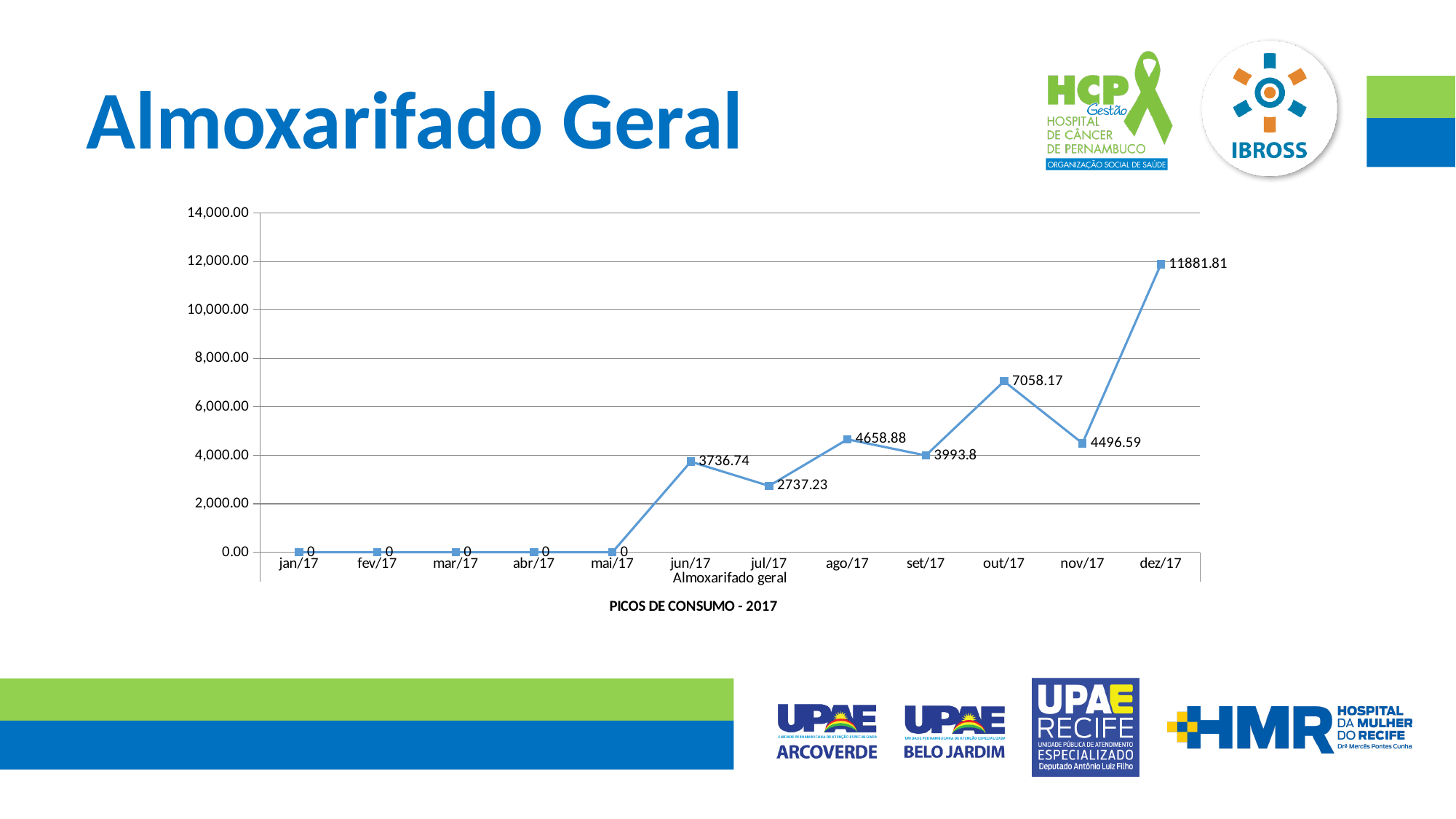
What is the value for set/17? 3993.8 Which month has the highest value? dez/17 How many months are plotted on the x axis? 12 Which is larger, the value for nov/17 or the value for ago/17? ago/17 What is the difference between the values for ago/17 and jul/17? 1921.65 What is the difference between the values for dez/17 and out/17? 4823.64 What is the value for jun/17? 3736.74 Is the value for out/17 greater or less than 6,000.00? greater What is the text shown below the chart's x axis? PICOS DE CONSUMO - 2017 What kind of chart is shown? line chart What is the value for dez/17? 11881.81 What is the value for out/17? 7058.17